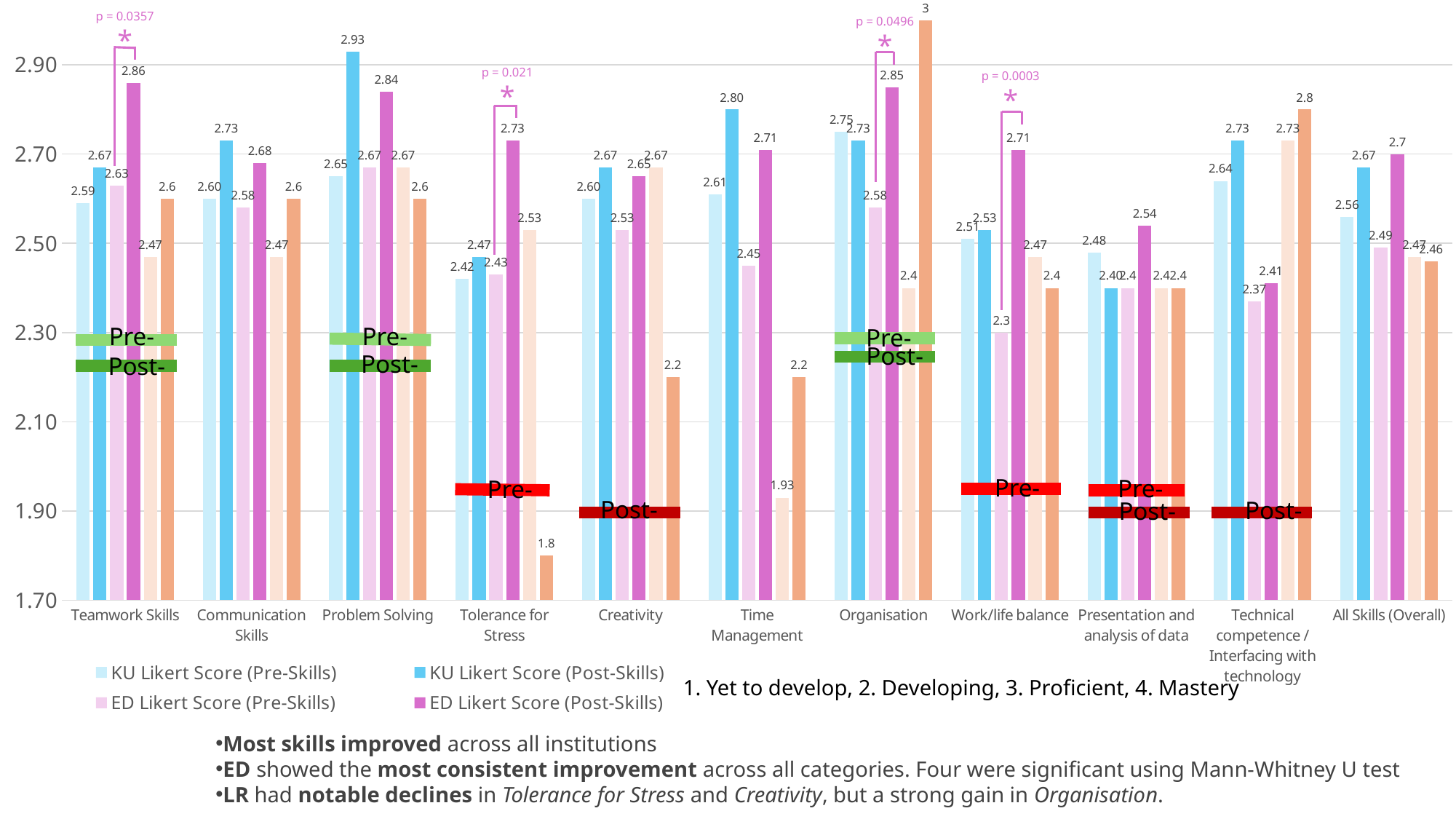
What is the ED Likert Score (Post-Skills) for Teamwork Skills? 2.86 Which category has the highest KU Likert Score (Post-Skills)? Problem Solving What kind of chart is shown on the slide? Bar chart Which is larger for Organisation: the KU Likert Score (Pre-Skills) or the KU Likert Score (Post-Skills)? KU Likert Score (Pre-Skills) What is the difference between the ED Likert Score (Post-Skills) and the ED Likert Score (Pre-Skills) for Tolerance for Stress? 0.30 Is the ED Likert Score (Post-Skills) for Time Management greater or less than 2.50? greater What is the KU Likert Score (Post-Skills) for Problem Solving? 2.93 What is the ED Likert Score (Pre-Skills) for Work/life balance? 2.3 Which category has the lowest ED Likert Score (Pre-Skills)? Work/life balance What is the KU Likert Score (Pre-Skills) for All Skills (Overall)? 2.56 How many skill categories are shown on the x axis? 11 How many series does the legend list? 4